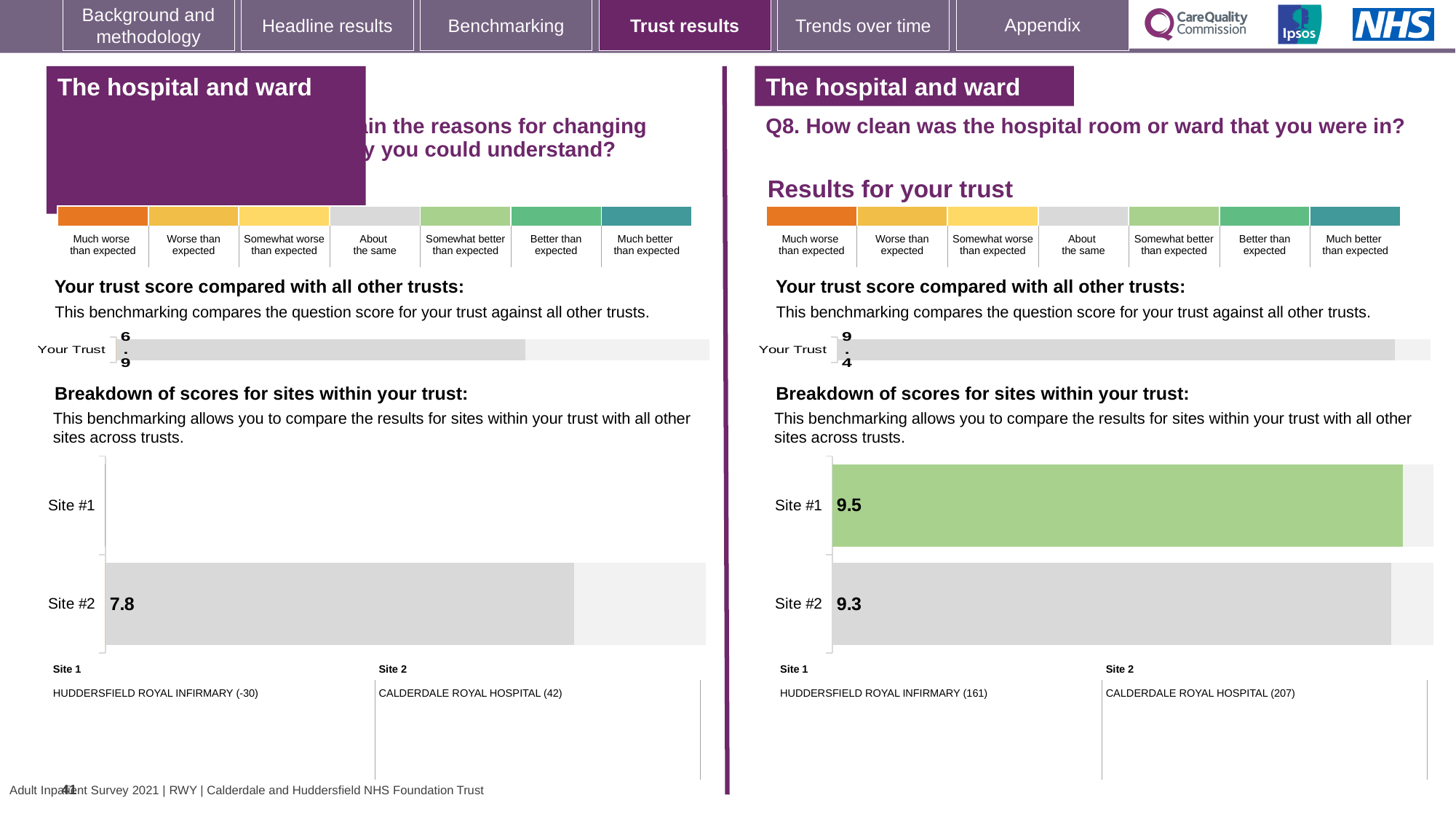
On the left-hand 'Breakdown of scores for sites within your trust' chart, what is the score for Site #2? 7.8 What is the difference between the Your Trust score on the right-hand chart (Q8) and the Your Trust score on the left-hand chart? 2.5 On the right-hand 'Breakdown of scores for sites within your trust' chart (Q8), what is the score for Site #1? 9.5 On the right-hand 'Breakdown of scores for sites within your trust' chart (Q8), which site has the lowest score? Site #2 How many sites are shown on the right-hand 'Breakdown of scores for sites within your trust' chart (Q8)? 2 On the right-hand 'Breakdown of scores for sites within your trust' chart (Q8), what is the score for Site #2? 9.3 On the right-hand 'Breakdown of scores for sites within your trust' chart (Q8), is the score for Site #1 larger or smaller than the score for Site #2? larger On the right-hand 'Breakdown of scores for sites within your trust' chart (Q8), which site has the highest score? Site #1 On the left-hand 'Your trust score compared with all other trusts' chart, what is the score for Your Trust? 6.9 On the right-hand 'Your trust score compared with all other trusts' chart (Q8), what is the score for Your Trust? 9.4 What kind of chart is the right-hand 'Breakdown of scores for sites within your trust' chart (Q8)? bar chart On the right-hand 'Breakdown of scores for sites within your trust' chart (Q8), what is the difference between the Site #1 and Site #2 scores? 0.2